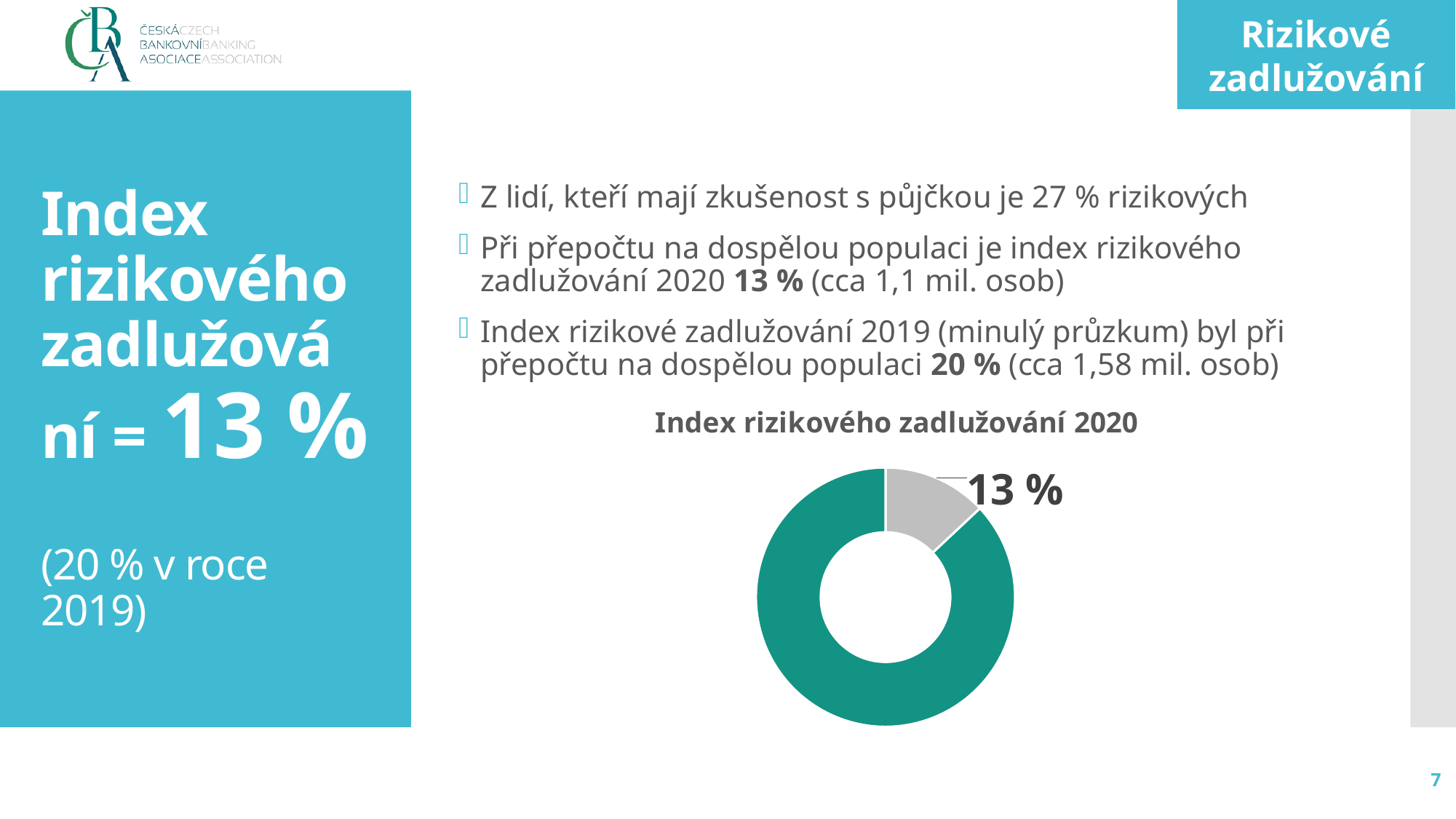
What colour is the segment labelled 13 %? grey Does the teal segment cover more or less than half of the doughnut? more What kind of chart is shown on the slide? doughnut chart How many segments does the doughnut chart have? 2 Which segment of the doughnut is larger, the grey one or the teal one? the teal one What share of the doughnut does the labelled grey segment represent? 13 % What value is printed on the data label of the chart? 13 % What is the title of the chart on the slide? Index rizikového zadlužování 2020